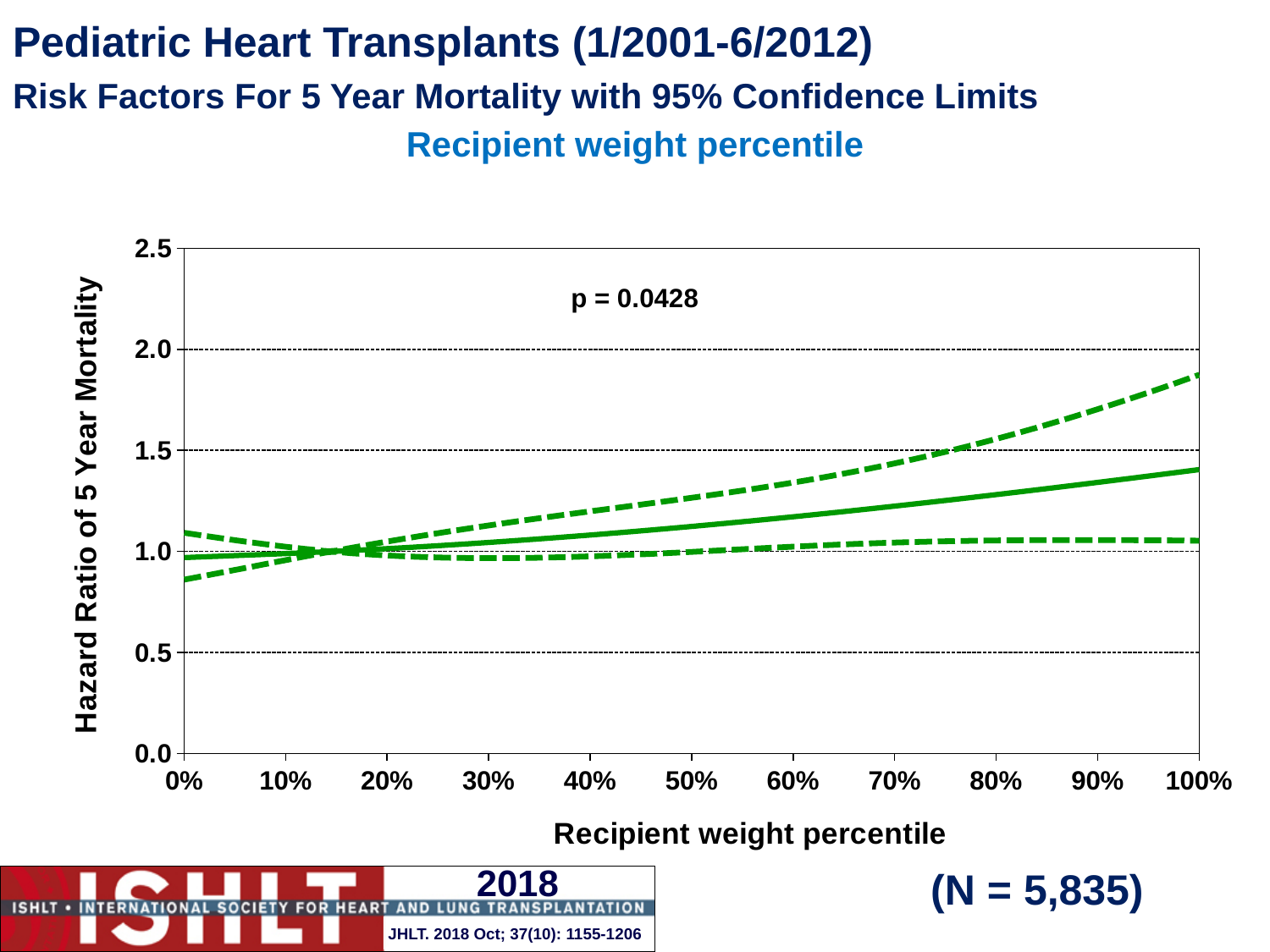
Is the value of the solid hazard ratio line at 100% recipient weight percentile greater or less than 1.5? less Is the lower dashed confidence limit at 0% recipient weight percentile greater or less than 1.0? less How many lines are plotted on the chart? 3 What p-value is printed on the chart? p = 0.0428 Is the upper dashed confidence limit at 100% recipient weight percentile greater or less than 2.0? less Is the solid hazard ratio line higher at 100% or at 0% recipient weight percentile? 100% What kind of chart is shown on the slide? line chart What sample size (N) is shown on the slide? N = 5,835 Does the solid hazard ratio line rise or fall as recipient weight percentile increases from 0% to 100%? rise